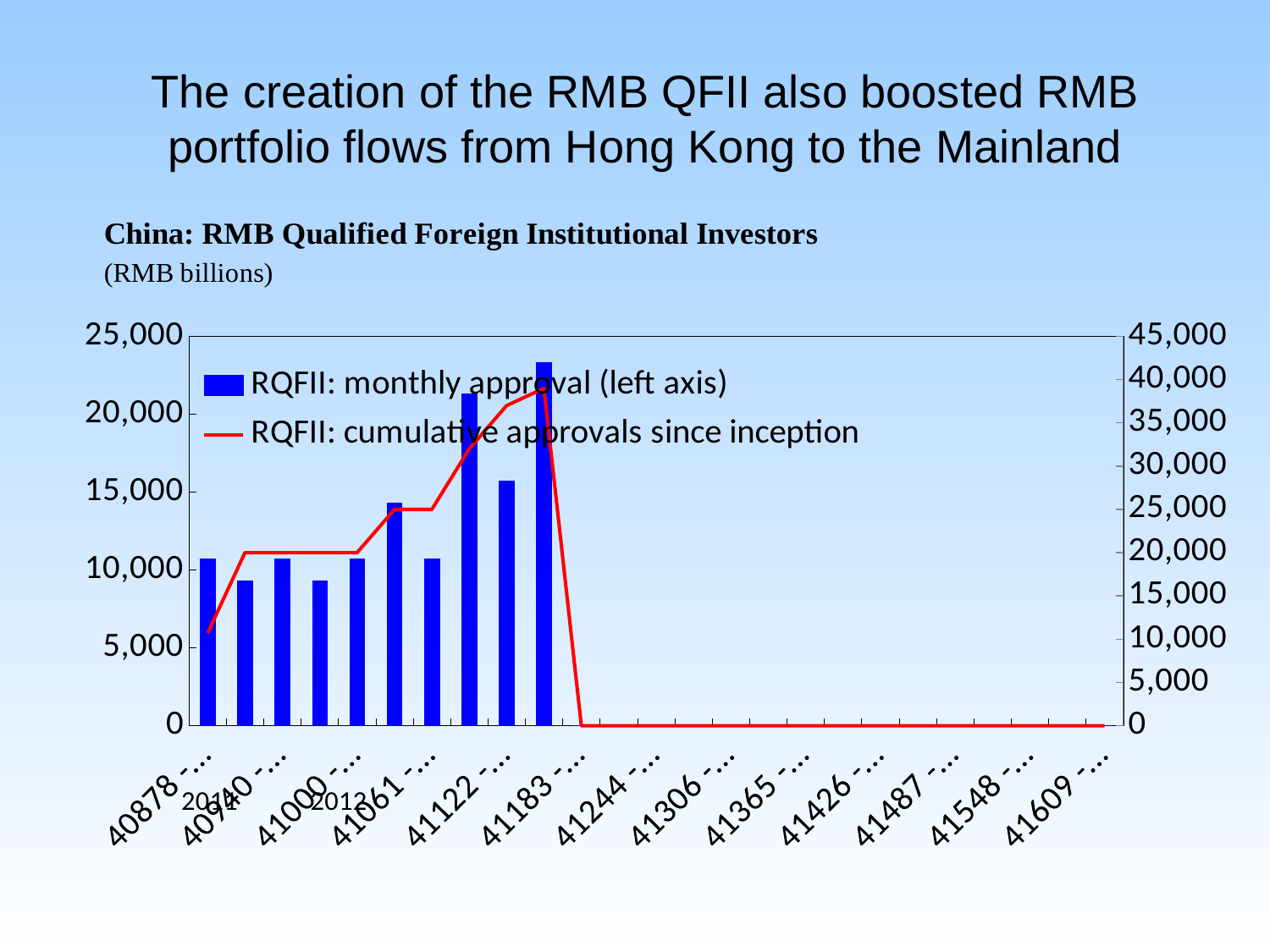
What kind of chart is shown on the slide? A combination bar and line chart Which is larger, the first monthly approval bar or the second monthly approval bar? The first bar In what units are the chart values expressed? RMB billions Is the tallest monthly approval bar greater or less than 20,000 on the left axis? greater How many series does the chart legend list? 2 Which monthly approval bar is the highest? The rightmost (last) bar Is the peak of the cumulative approvals line greater or less than 35,000 on the right axis? greater What is the title of the chart? China: RMB Qualified Foreign Institutional Investors Which series is plotted as bars on the left axis? RQFII: monthly approval (left axis) How many bars (monthly approval values) are plotted in the chart? 10 Is the first (leftmost) monthly approval bar greater or less than 15,000 on the left axis? less